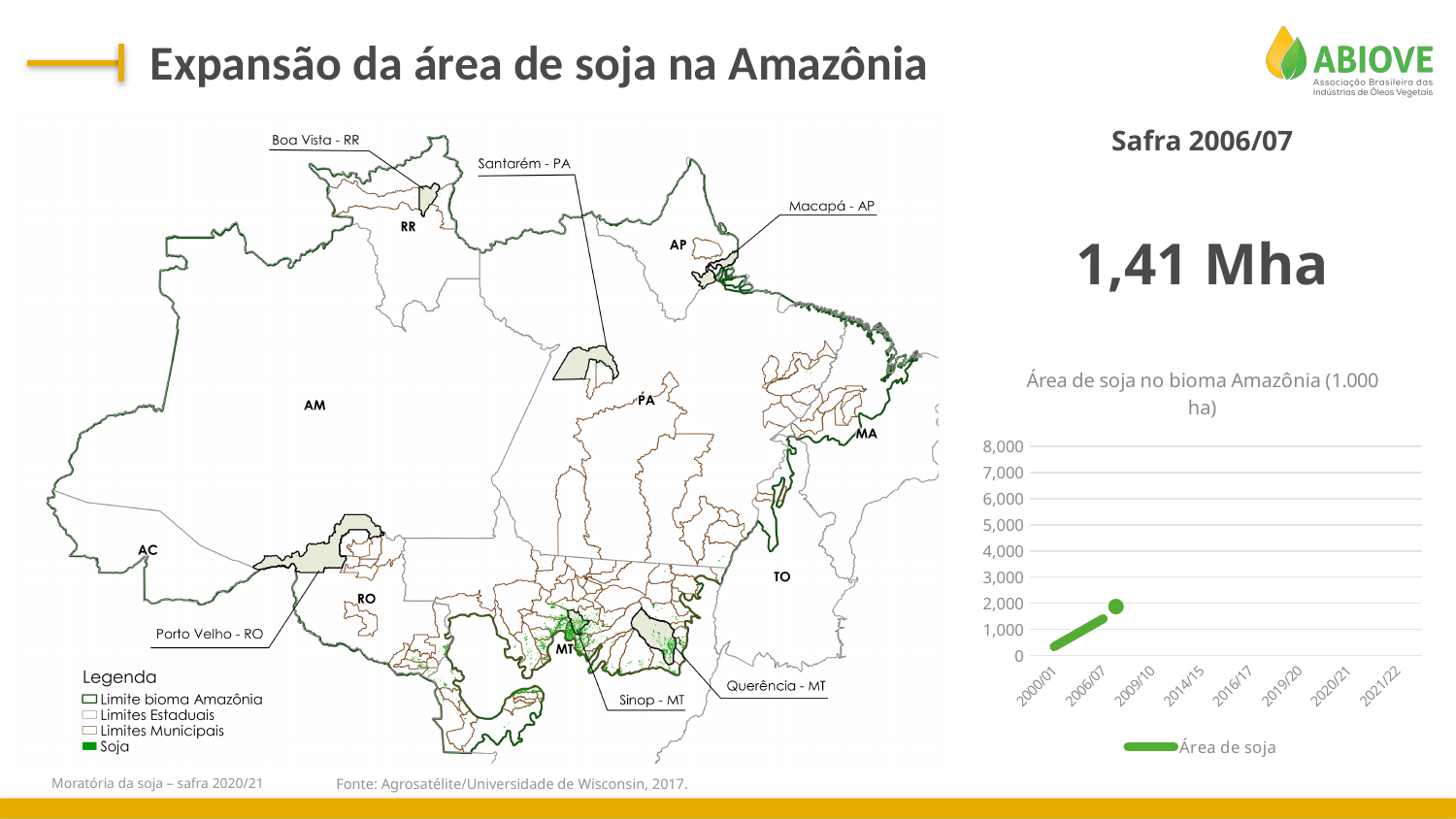
What is the name of the series shown in the legend of the chart on the right? Área de soja What kind of chart is shown on the right side of the slide? line chart In the chart 'Área de soja no bioma Amazônia (1.000 ha)', does the soy area rise or fall from 2000/01 to 2006/07? rise What is the highest tick value shown on the y axis of the chart 'Área de soja no bioma Amazônia (1.000 ha)'? 8,000 In the chart 'Área de soja no bioma Amazônia (1.000 ha)', which plotted season has the highest value? 2006/07 In the chart 'Área de soja no bioma Amazônia (1.000 ha)', which has the larger value, 2000/01 or 2006/07? 2006/07 In the chart 'Área de soja no bioma Amazônia (1.000 ha)', is the value for 2006/07 greater or less than 3,000? less In the chart 'Área de soja no bioma Amazônia (1.000 ha)', is the value for 2000/01 greater or less than 1,000? less How many series does the legend of the chart 'Área de soja no bioma Amazônia (1.000 ha)' list? 1 How many season labels are shown on the x axis of the chart 'Área de soja no bioma Amazônia (1.000 ha)'? 8 In the chart 'Área de soja no bioma Amazônia (1.000 ha)', is the value for 2006/07 greater or less than 1,000? greater